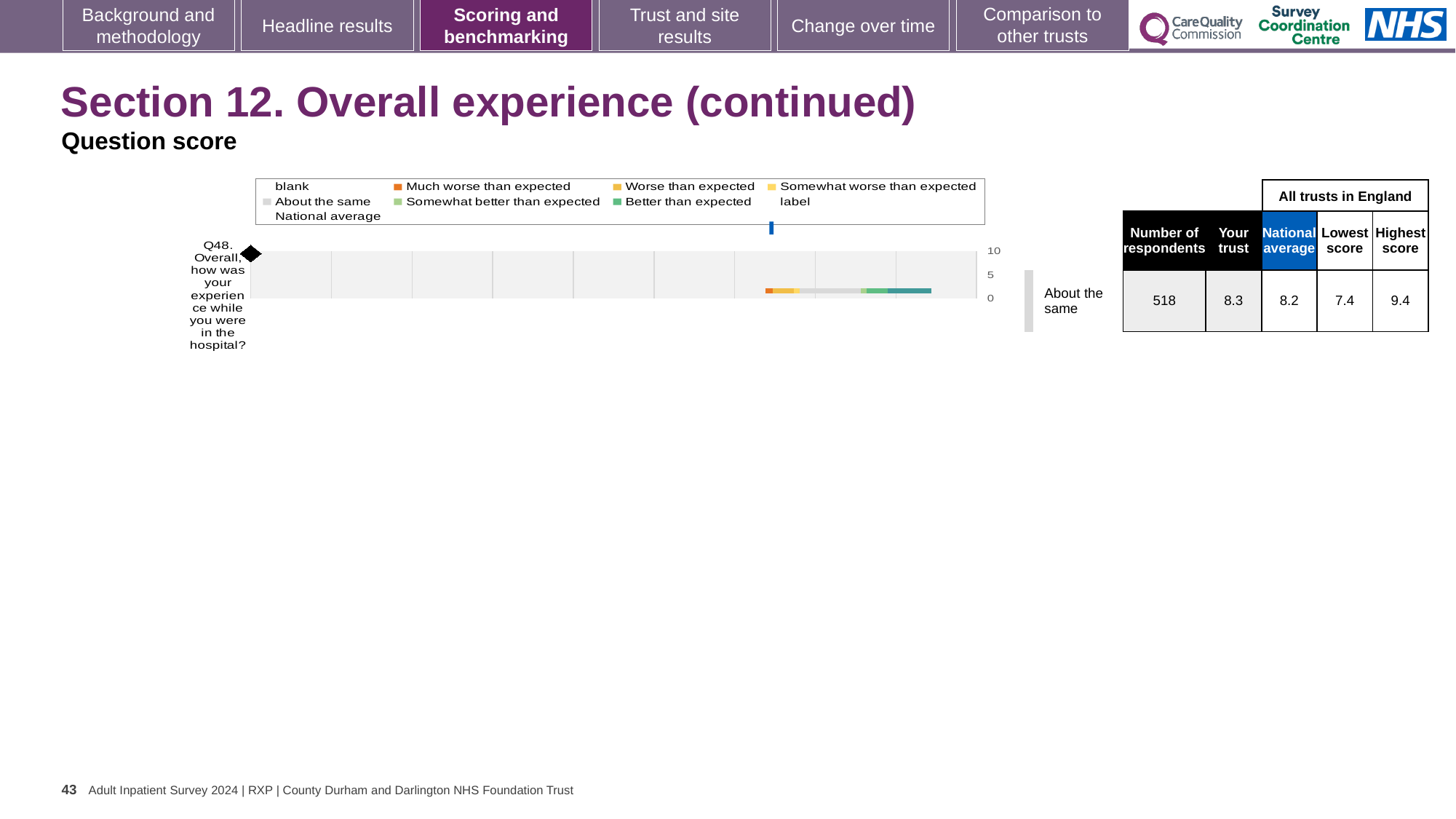
How many questions (categories) are plotted on the chart? 1 What is the difference between the highest score and the lowest score for Q48 in the table beside the chart? 2.0 According to the table beside the chart, what is the 'Your trust' score for Q48? 8.3 According to the table beside the chart, what is the highest score among all trusts in England for Q48? 9.4 According to the table beside the chart, how many respondents answered Q48? 518 What is the highest value shown on the chart's axis? 10 Which is larger for Q48, the 'Your trust' score or the national average? Your trust Which question is plotted on the chart? Q48. Overall, how was your experience while you were in the hospital? According to the table beside the chart, what is the lowest score among all trusts in England for Q48? 7.4 How many entries does the chart legend list? 9 What kind of chart is shown on the slide? Bar chart According to the table beside the chart, what is the national average score for Q48? 8.2